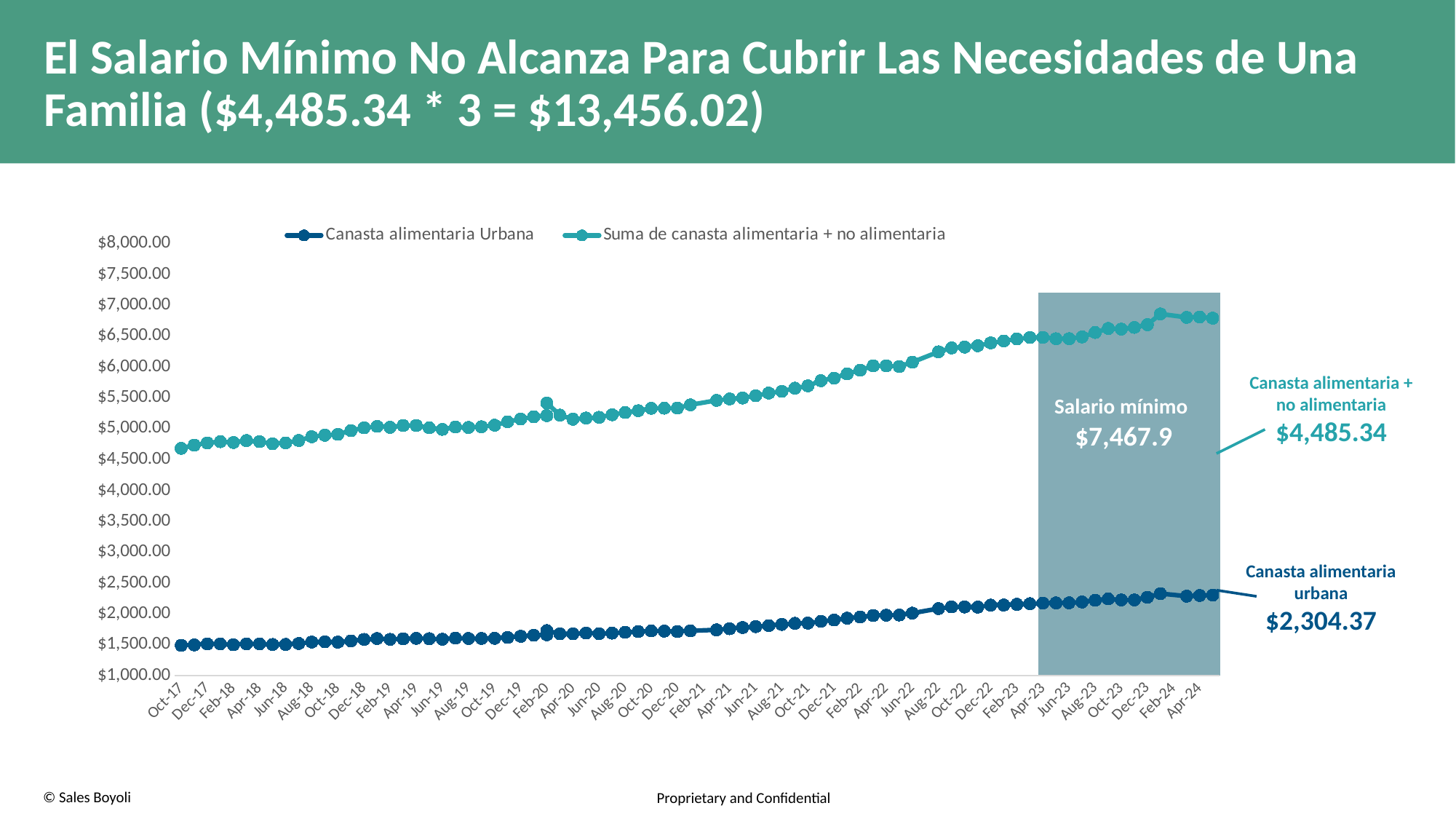
What are the two series named in the chart legend? Canasta alimentaria Urbana; Suma de canasta alimentaria + no alimentaria How many series does the chart legend list? 2 Which series has the higher values throughout the chart, Canasta alimentaria Urbana or Suma de canasta alimentaria + no alimentaria? Suma de canasta alimentaria + no alimentaria Is the value of the Suma de canasta alimentaria + no alimentaria series at Oct-17 greater or less than $5,000.00? less What Salario mínimo value is printed in the shaded area of the chart? $7,467.9 What value is annotated for Canasta alimentaria urbana at the right of the chart? $2,304.37 Is the value of the Canasta alimentaria Urbana series at Oct-17 greater or less than $2,000.00? less What value is annotated for Canasta alimentaria + no alimentaria at the right of the chart? $4,485.34 What is the difference between the annotated Canasta alimentaria + no alimentaria value ($4,485.34) and the annotated Canasta alimentaria urbana value ($2,304.37)? $2,180.97 Is the value of the Suma de canasta alimentaria + no alimentaria series at Apr-24 greater or less than $6,500.00? greater Do the values of the Suma de canasta alimentaria + no alimentaria series rise or fall from Oct-17 to Apr-24? rise What kind of chart is shown on the slide? line chart